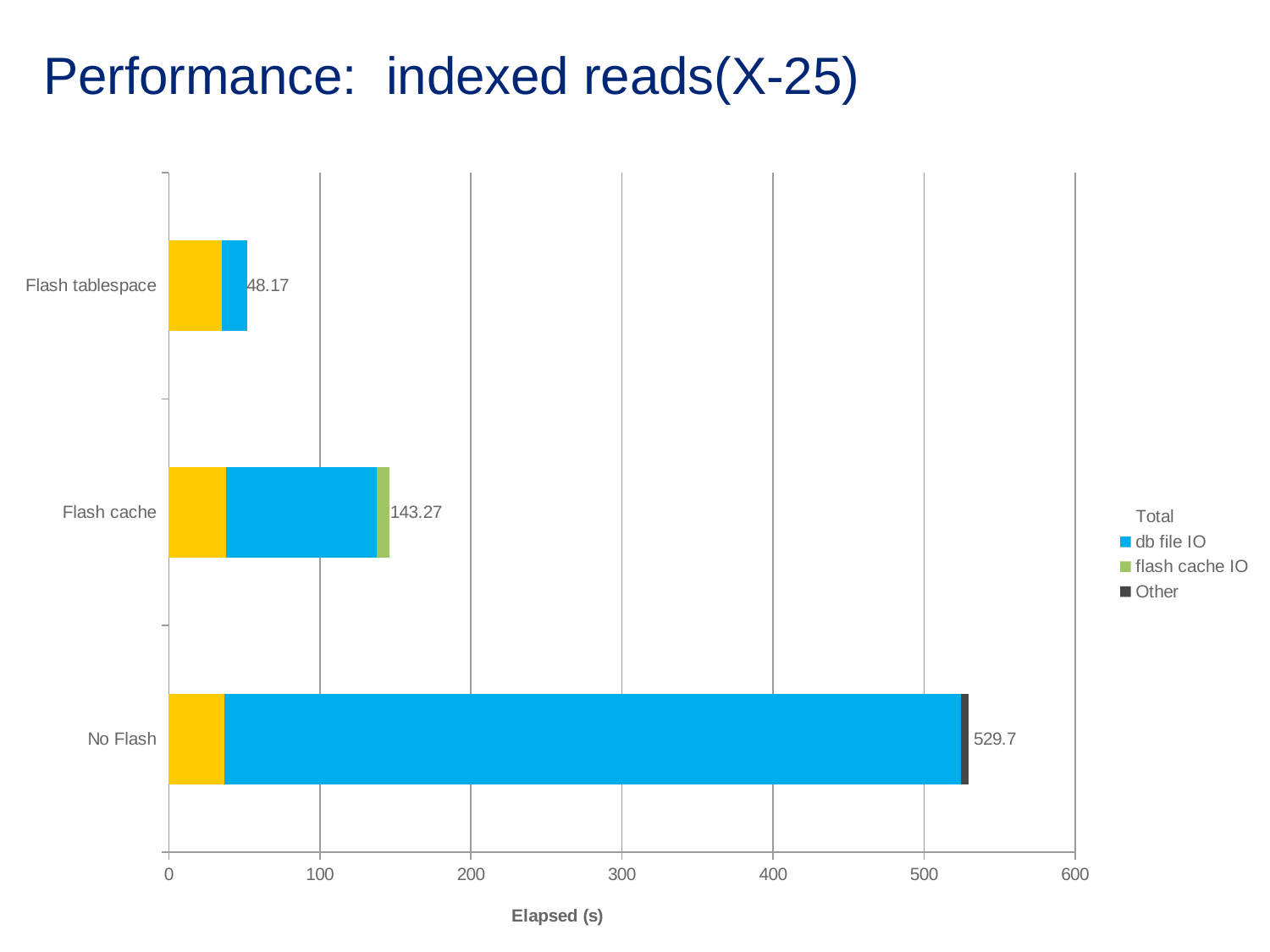
What is the total value labelled for the Flash cache bar? 143.27 What is the total value labelled for the No Flash bar? 529.7 What is the difference between the total for No Flash and the total for Flash cache? 386.43 What kind of chart is shown on the slide? Stacked bar chart What is the total value labelled for the Flash tablespace bar? 48.17 Is the total for No Flash greater or less than 500? greater Which has a larger total elapsed time, Flash cache or Flash tablespace? Flash cache What is the difference between the total for Flash cache and the total for Flash tablespace? 95.1 What is the title of the horizontal axis? Elapsed (s) Which category has the highest total elapsed time? No Flash How many categories are shown on the chart? 3 Which category has the lowest total elapsed time? Flash tablespace